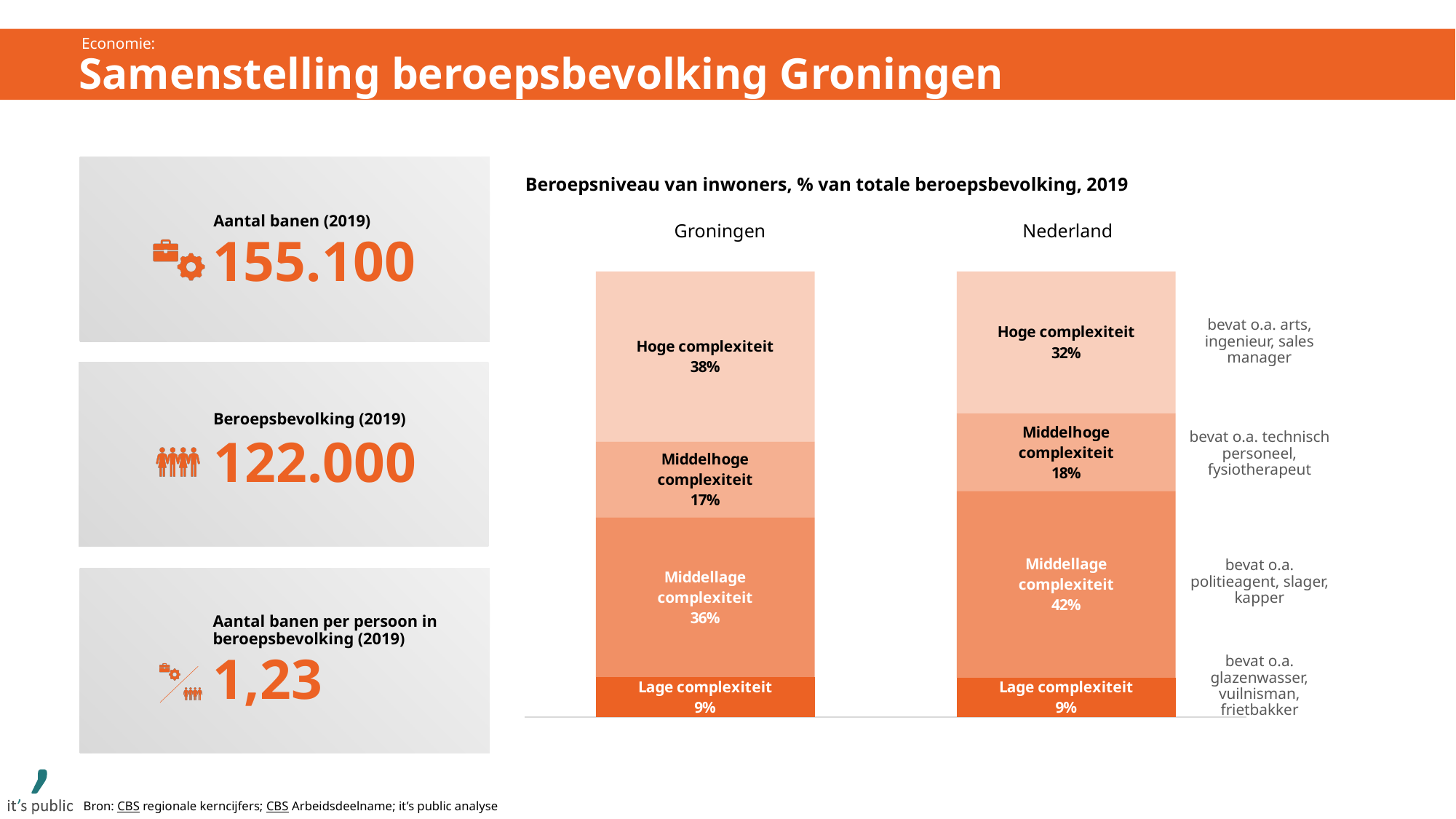
What share of the Groningen workforce is in 'Middelhoge complexiteit'? 17% What is the value for 'Middellage complexiteit' in the Nederland bar? 42% How many stacked bars does the chart show? 2 How many percentage points higher is 'Hoge complexiteit' in Groningen than in Nederland? 6 Which segment is the largest in the Groningen bar? Hoge complexiteit Which has a larger share of 'Middellage complexiteit', Groningen or Nederland? Nederland Which segment is the largest in the Nederland bar? Middellage complexiteit Which segment is the smallest in the Groningen bar? Lage complexiteit What is the value for 'Lage complexiteit' in the Nederland bar? 9% What percentage of the Groningen workforce is in 'Hoge complexiteit'? 38% How many complexity levels (segments) are shown in each bar? 4 What type of chart is shown on the slide? Stacked bar chart